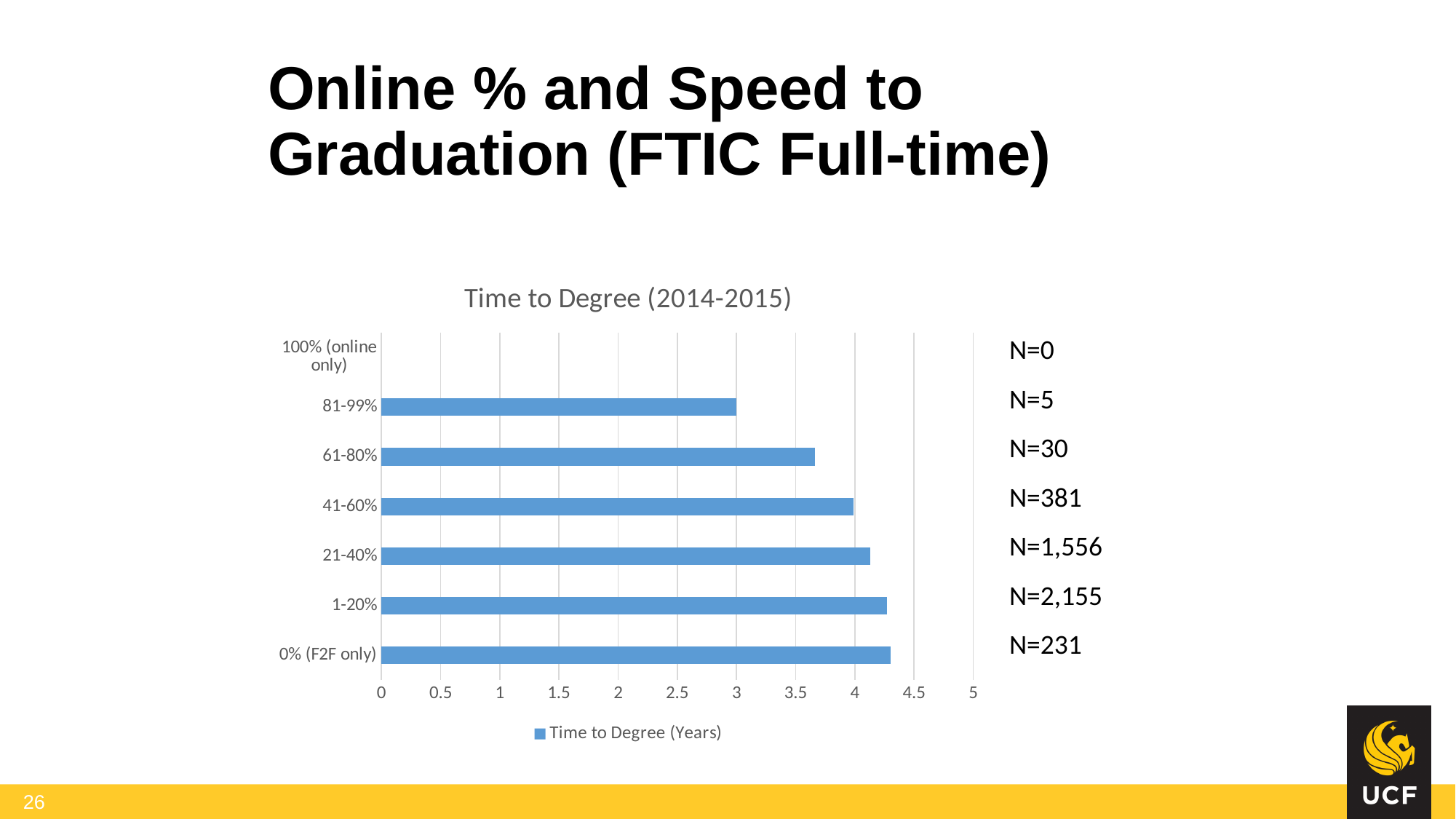
Which category has no bar plotted in the chart? 100% (online only) Which has a longer time to degree, 61-80% or 41-60%? 41-60% Which has a longer time to degree, 81-99% or 61-80%? 61-80% Is the time to degree for 61-80% greater or less than 3.5 years? greater What kind of chart is shown on the slide? bar chart Is the time to degree for 21-40% greater or less than 4 years? greater As the online percentage increases from 0% (F2F only) to 81-99%, does the time to degree rise or fall? fall How many categories are shown on the vertical axis of the chart? 7 What is the title of the chart? Time to Degree (2014-2015) Is the time to degree for 81-99% greater or less than 3.5 years? less How many series does the legend list? 1